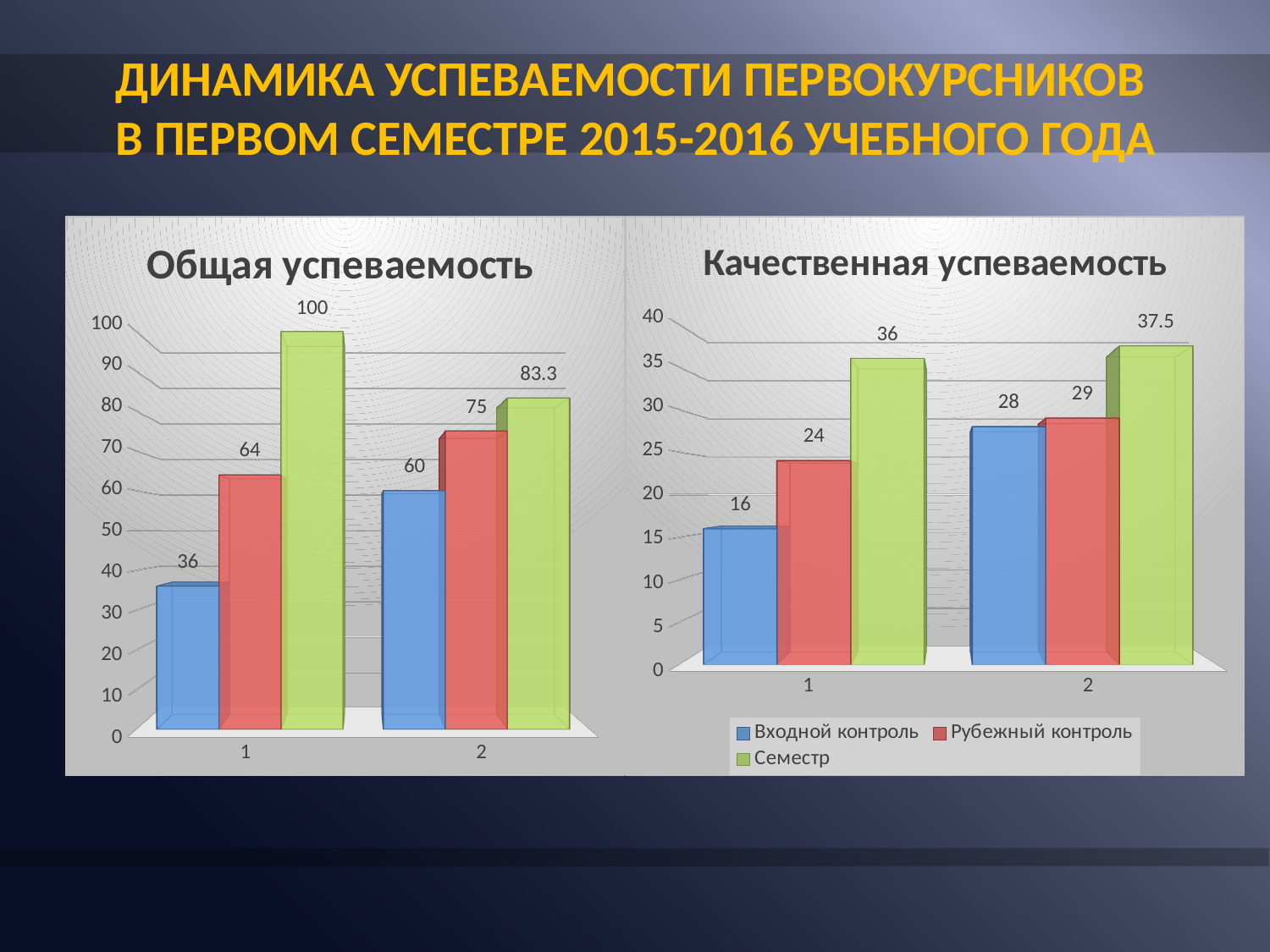
In the 'Качественная успеваемость' chart, what is the difference between 'Семестр' and 'Входной контроль' for category 1? 20 In the 'Общая успеваемость' chart, what is the difference between the green bar and the blue bar for category 2? 23.3 In the 'Общая успеваемость' chart, what is the value of the red bar for category 1? 64 In the 'Общая успеваемость' chart, which bar is the lowest? Blue bar for category 1 (36) In the 'Общая успеваемость' chart, what is the value of the green bar for category 1? 100 How many series does the legend of the 'Качественная успеваемость' chart list? 3 In the 'Качественная успеваемость' chart, what is the value of 'Входной контроль' for category 1? 16 In the 'Общая успеваемость' chart, what is the value of the blue bar for category 2? 60 In the 'Качественная успеваемость' chart, what is the value of 'Семестр' for category 2? 37.5 In the 'Качественная успеваемость' chart, which is larger for category 2: 'Входной контроль' or 'Рубежный контроль'? Рубежный контроль In the 'Качественная успеваемость' chart, does the value of 'Входной контроль' rise or fall from category 1 to category 2? Rise What type of chart is 'Общая успеваемость'? Bar chart